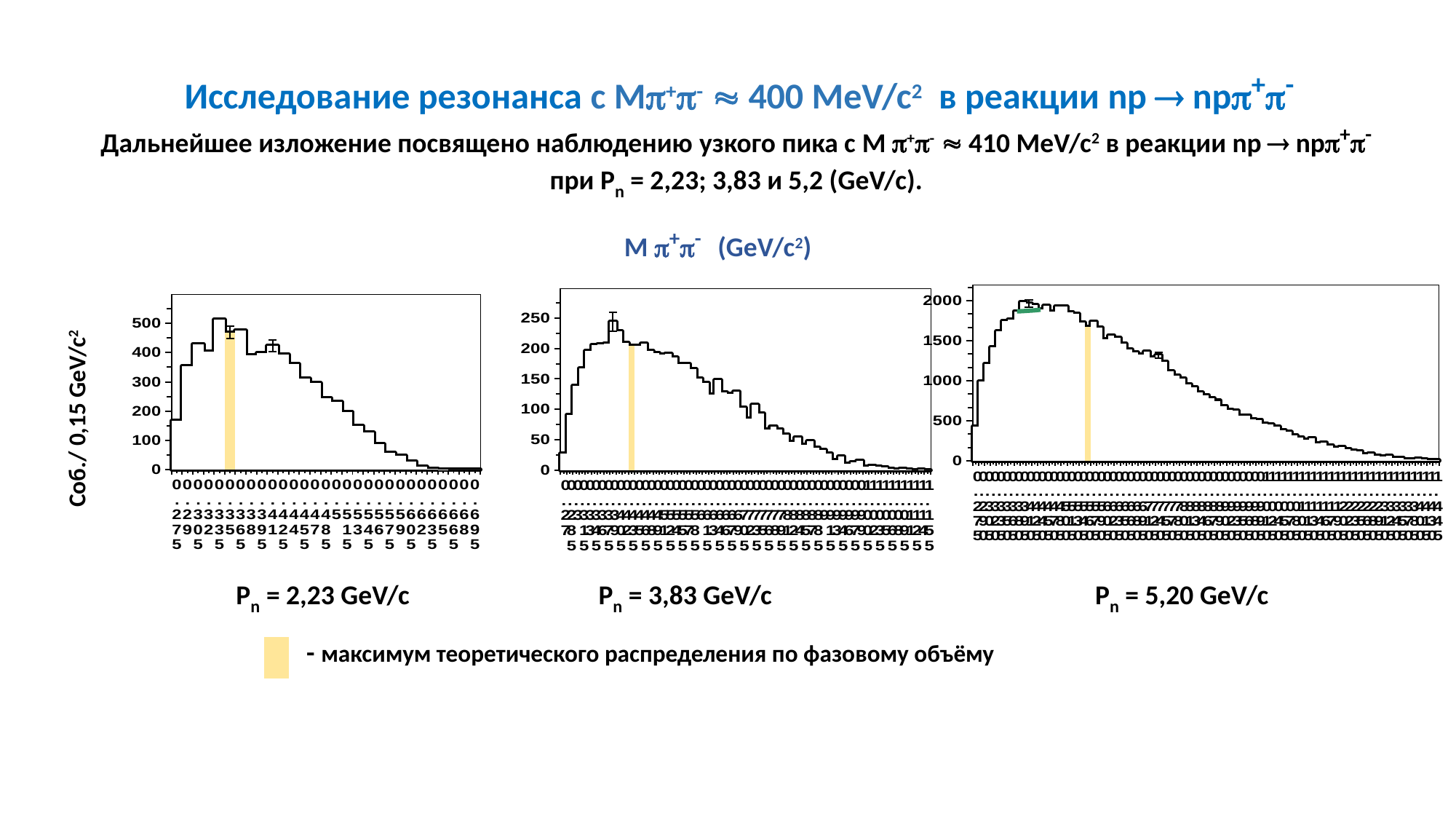
What is the neutron momentum Pn for the middle chart? 3,83 GeV/c In the middle chart (Pn = 3,83 GeV/c), is the highest bin greater or less than 200? greater How many charts are shown on the slide? 3 In the right chart (Pn = 5,20 GeV/c), are the bins at the far right end of the x axis greater or less than 500? less What is the highest tick value on the y axis of the right chart (Pn = 5,20 GeV/c)? 2000 Which chart has the larger peak value: the left chart (Pn = 2,23 GeV/c) or the right chart (Pn = 5,20 GeV/c)? the right chart (Pn = 5,20 GeV/c) What kind of chart is the left chart (Pn = 2,23 GeV/c)? histogram In the left chart (Pn = 2,23 GeV/c), is the highest bin greater or less than 400? greater What is the y-axis label shared by the charts? Соб./ 0,15 GeV/c² In the middle chart (Pn = 3,83 GeV/c), do the values rise or fall along the x axis after the peak? fall